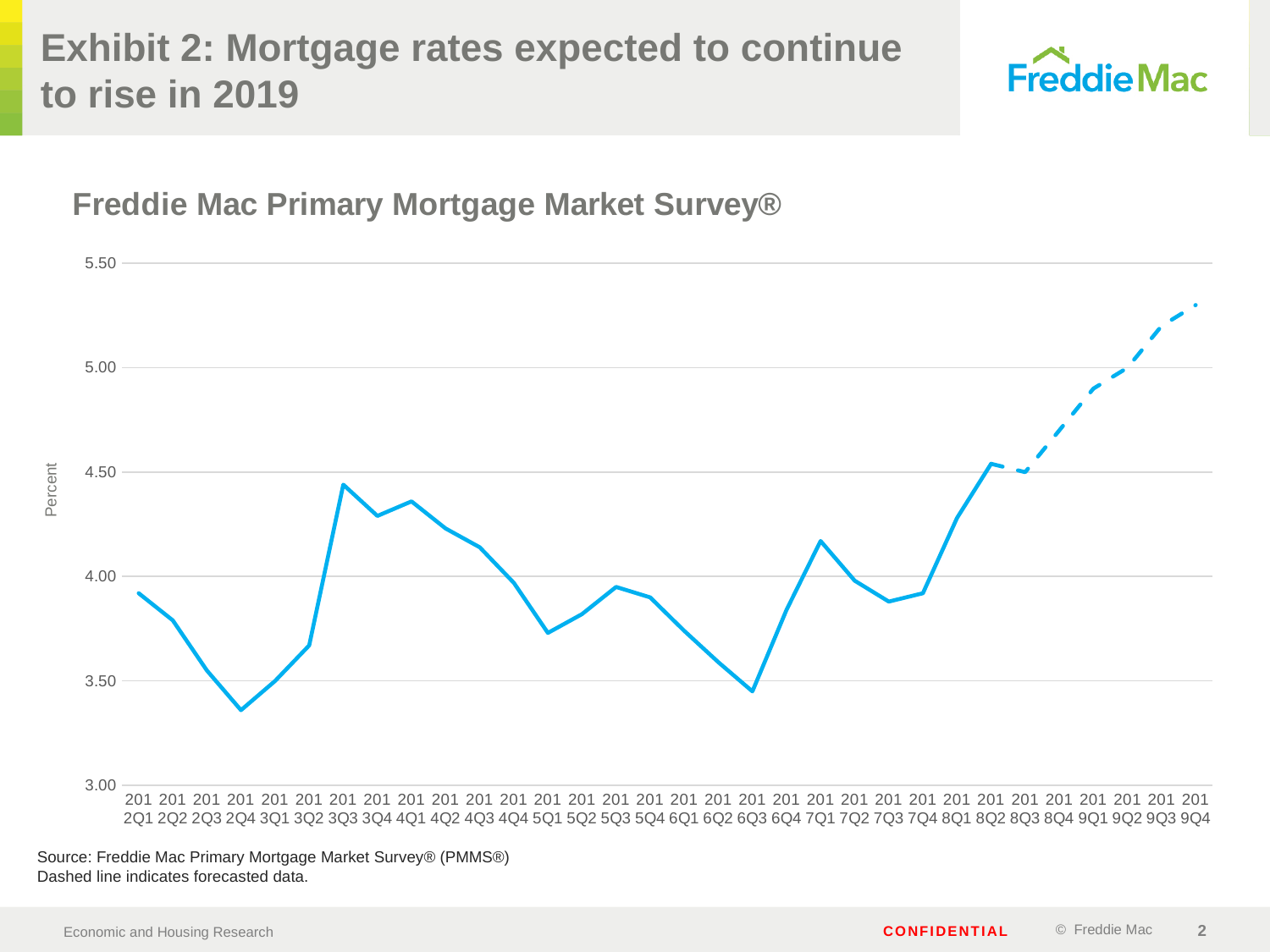
What is the title of the chart? Freddie Mac Primary Mortgage Market Survey® Do the values rise or fall from 2018Q3 to 2019Q4? rise Which quarter has the highest value on the chart? 2019Q4 Which is larger, the value for 2013Q3 or the value for 2016Q3? 2013Q3 What kind of chart is shown on the slide? line chart Is the value for 2016Q3 greater or less than 3.50? less Is the value for 2013Q3 greater or less than 4.00? greater How many quarterly data points are plotted on the chart? 32 Which quarter has the lowest value on the chart? 2012Q4 What is the label on the vertical axis of the chart? Percent Is the value for 2012Q4 greater or less than 3.50? less